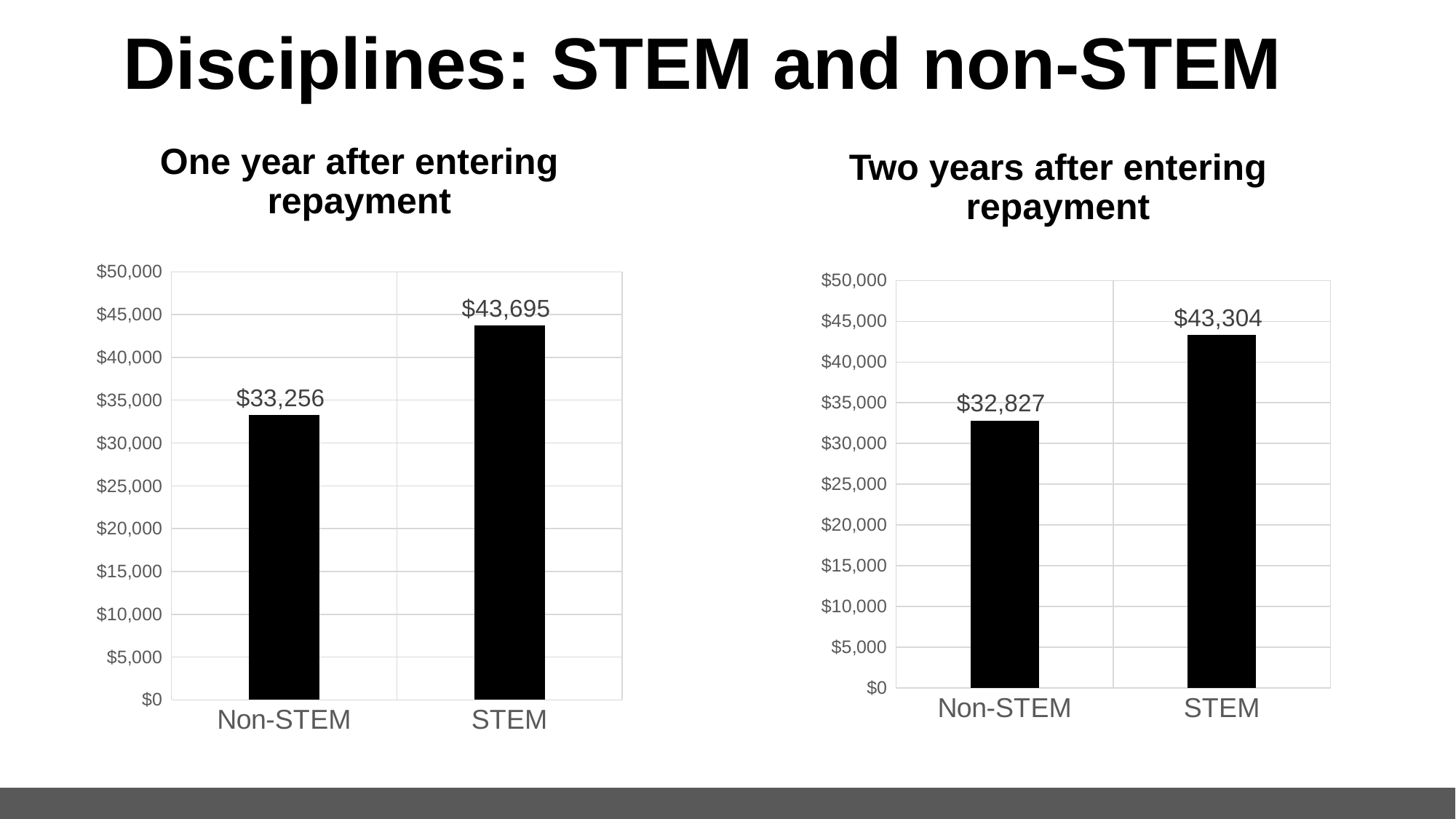
What kind of chart is the 'One year after entering repayment' chart? bar chart In the 'One year after entering repayment' chart, what is the value for Non-STEM? $33,256 In the 'Two years after entering repayment' chart, what is the value for STEM? $43,304 How many categories are shown in the 'Two years after entering repayment' chart? 2 In the 'Two years after entering repayment' chart, what is the value for Non-STEM? $32,827 In the 'Two years after entering repayment' chart, which is larger, the value for STEM or for Non-STEM? STEM In the 'Two years after entering repayment' chart, which category has the lowest value? Non-STEM In the 'One year after entering repayment' chart, is the value for Non-STEM greater or less than $35,000? less In the 'One year after entering repayment' chart, which category has the highest value? STEM In the 'One year after entering repayment' chart, what is the difference between the STEM and Non-STEM values? $10,439 In the 'One year after entering repayment' chart, what is the value for STEM? $43,695 In the 'Two years after entering repayment' chart, what is the difference between the STEM and Non-STEM values? $10,477